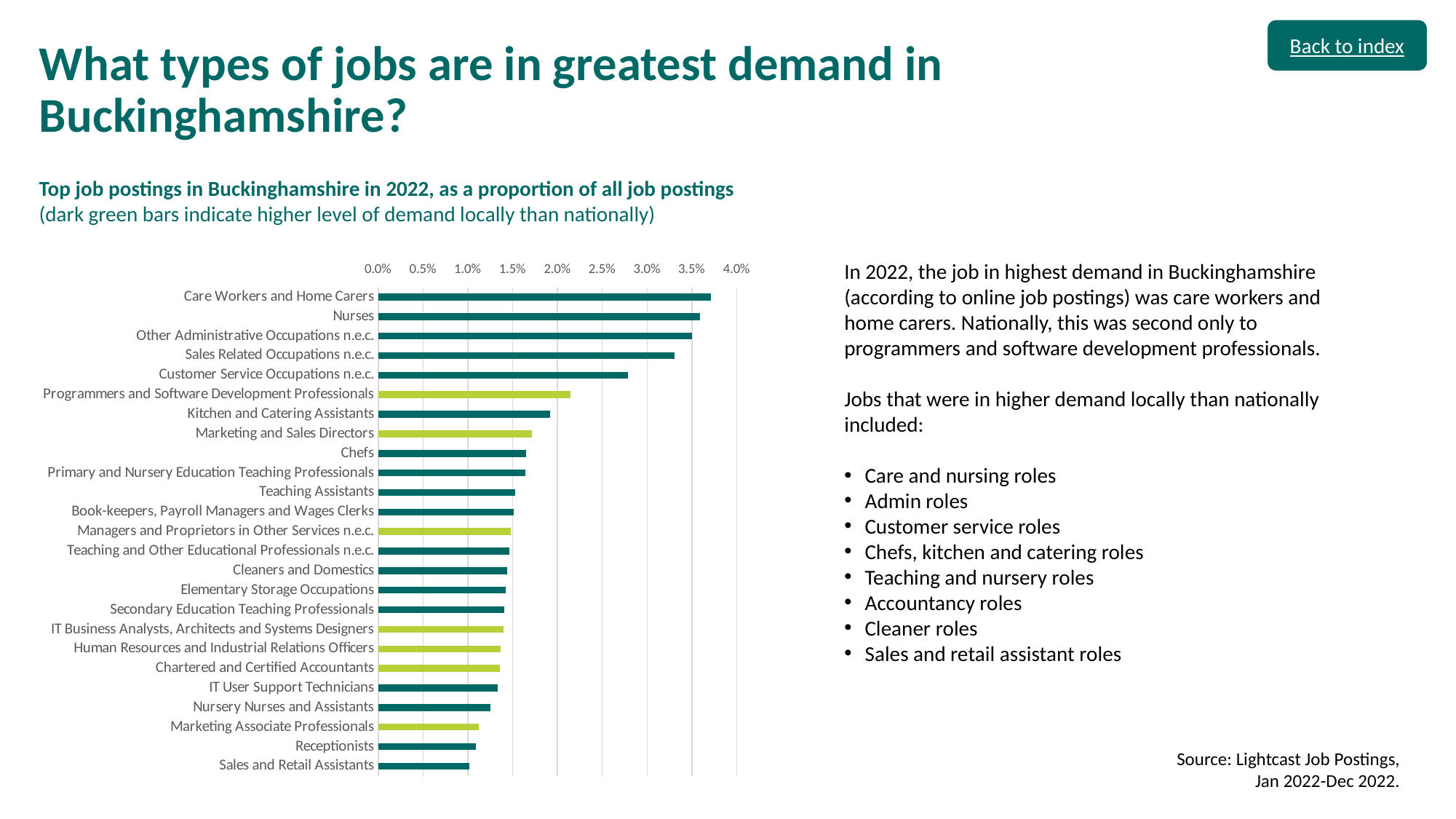
Is the value for Kitchen and Catering Assistants greater or less than 2.0%? less What is the highest value shown on the chart's horizontal axis? 4.0% According to the chart subtitle, what do the dark green bars indicate? Higher level of demand locally than nationally Is the value for Customer Service Occupations n.e.c. greater or less than 3.0%? less Which has a larger proportion of job postings: Programmers and Software Development Professionals or Kitchen and Catering Assistants? Programmers and Software Development Professionals Is the value for Programmers and Software Development Professionals greater or less than 2.0%? greater What kind of chart is shown on the slide? Bar chart Which job category has the highest proportion of job postings in the chart? Care Workers and Home Carers Which has a larger proportion of job postings: Sales Related Occupations n.e.c. or Customer Service Occupations n.e.c.? Sales Related Occupations n.e.c. How many job categories are plotted in the chart? 25